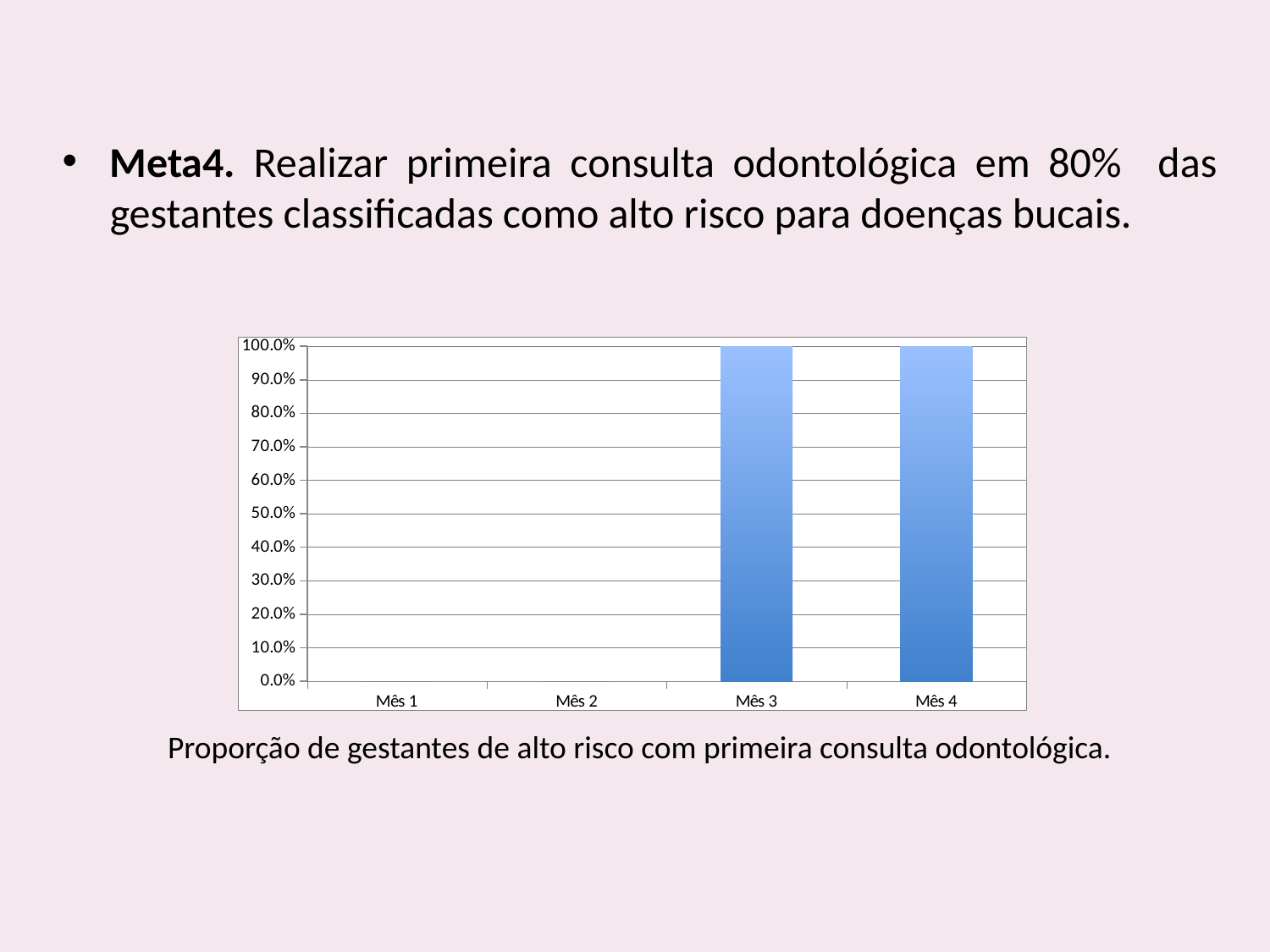
Do the values rise or fall from Mês 2 to Mês 3? rise What is the difference between the value for Mês 4 and the value for Mês 1? 100.0% Which is larger, the value for Mês 2 or the value for Mês 4? Mês 4 Is the value for Mês 3 greater or less than 80.0%? greater What is the value for Mês 3 in the chart? 100.0% What is the caption written below the chart? Proporção de gestantes de alto risco com primeira consulta odontológica. What is the value for Mês 2 in the chart? 0.0% What kind of chart is shown on the slide? bar chart Is the value for Mês 2 greater or less than 50.0%? less What is the value for Mês 1 in the chart? 0.0% What is the value for Mês 4 in the chart? 100.0% How many categories are shown on the x axis of the chart? 4